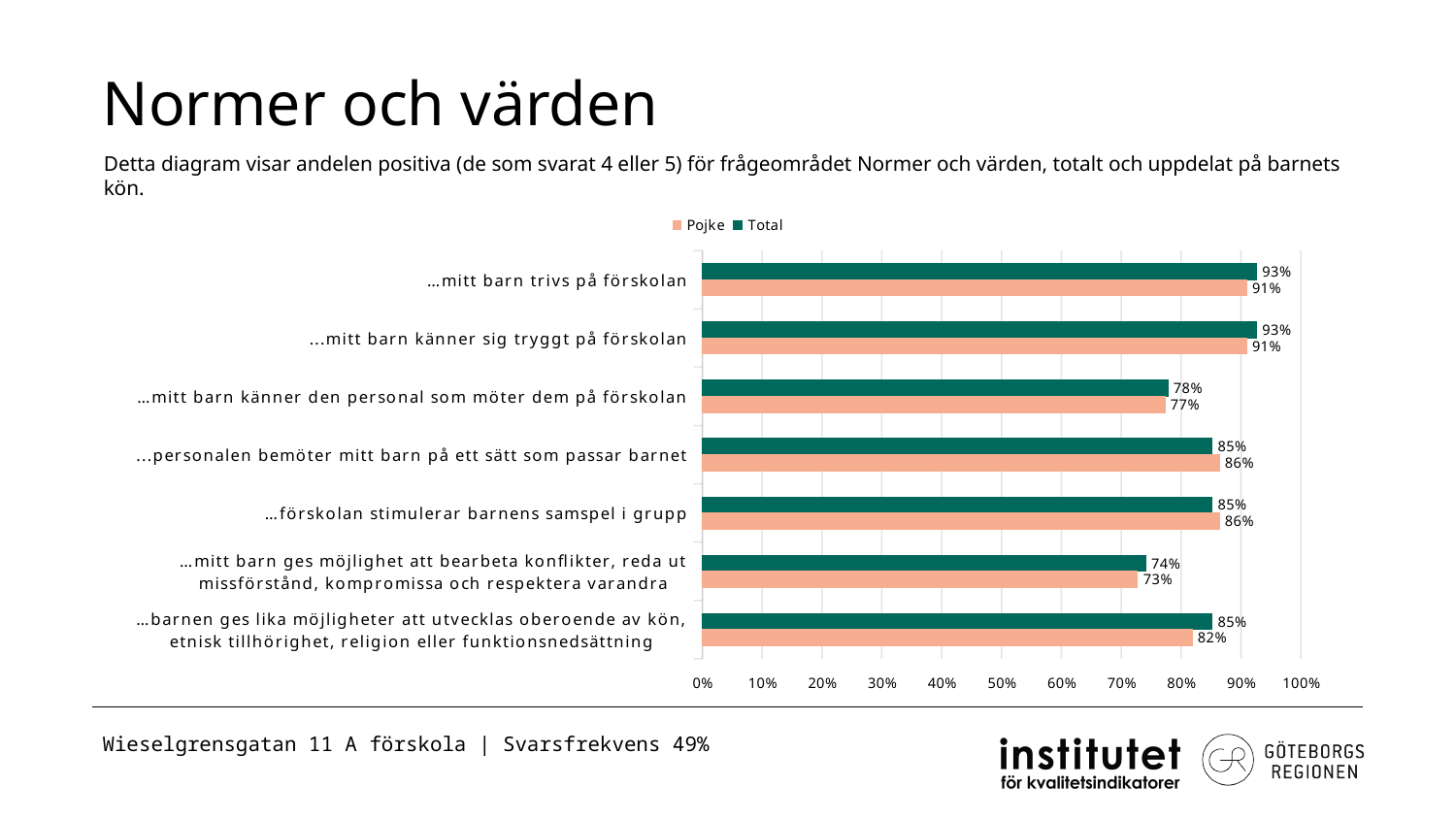
Which series is shown in dark green in the chart? Total What type of chart is shown on the slide? bar chart What is the Pojke value for "…barnen ges lika möjligheter att utvecklas oberoende av kön, etnisk tillhörighet, religion eller funktionsnedsättning"? 82% Is the Total value for "…mitt barn ges möjlighet att bearbeta konflikter, reda ut missförstånd, kompromissa och respektera varandra" greater or less than 80%? less What is the Total value for "…mitt barn känner den personal som möter dem på förskolan"? 78% How many categories (statements) are shown in the chart? 7 Which category has the lowest Pojke value? …mitt barn ges möjlighet att bearbeta konflikter, reda ut missförstånd, kompromissa och respektera varandra How many series does the legend list? 2 What is the difference between the Total and Pojke values for "…barnen ges lika möjligheter att utvecklas oberoende av kön, etnisk tillhörighet, religion eller funktionsnedsättning"? 3 percentage points What is the Total value for "…mitt barn trivs på förskolan"? 93% What is the Pojke value for "…mitt barn känner sig tryggt på förskolan"? 91% For "…personalen bemöter mitt barn på ett sätt som passar barnet", which is larger: the Pojke value or the Total value? Pojke